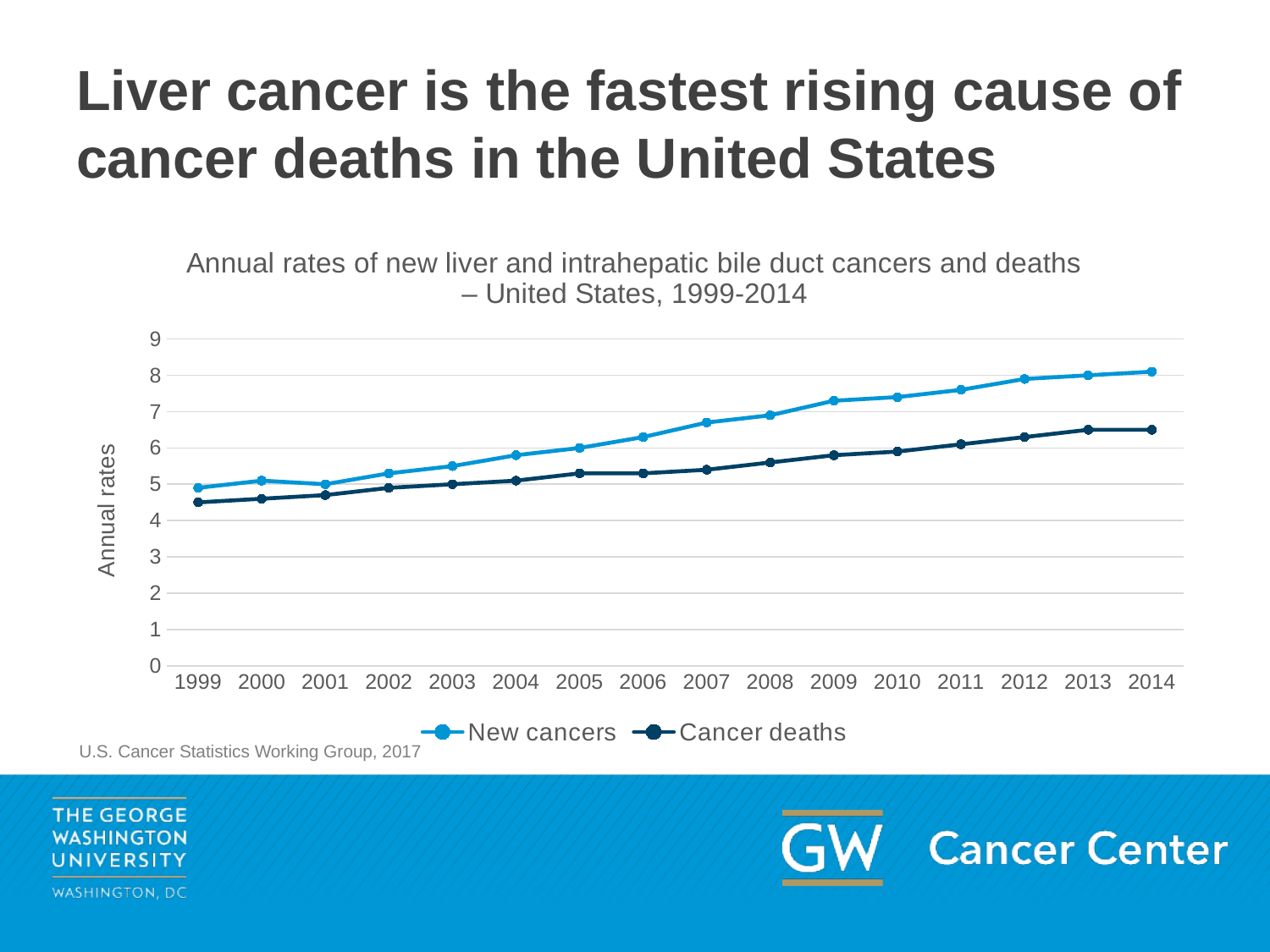
In 2014, which series has the larger value, New cancers or Cancer deaths? New cancers Is the value for New cancers in 2009 greater or less than 7? greater How many series does the legend list? 2 What kind of chart is shown on the slide? line chart What is the title of the chart? Annual rates of new liver and intrahepatic bile duct cancers and deaths – United States, 1999-2014 Is the value for Cancer deaths in 1999 greater or less than 5? less Is the value for Cancer deaths in 2008 greater or less than 6? less What is the label on the y axis? Annual rates Do the New cancers values rise or fall from 1999 to 2014? rise How many years are plotted along the x axis? 16